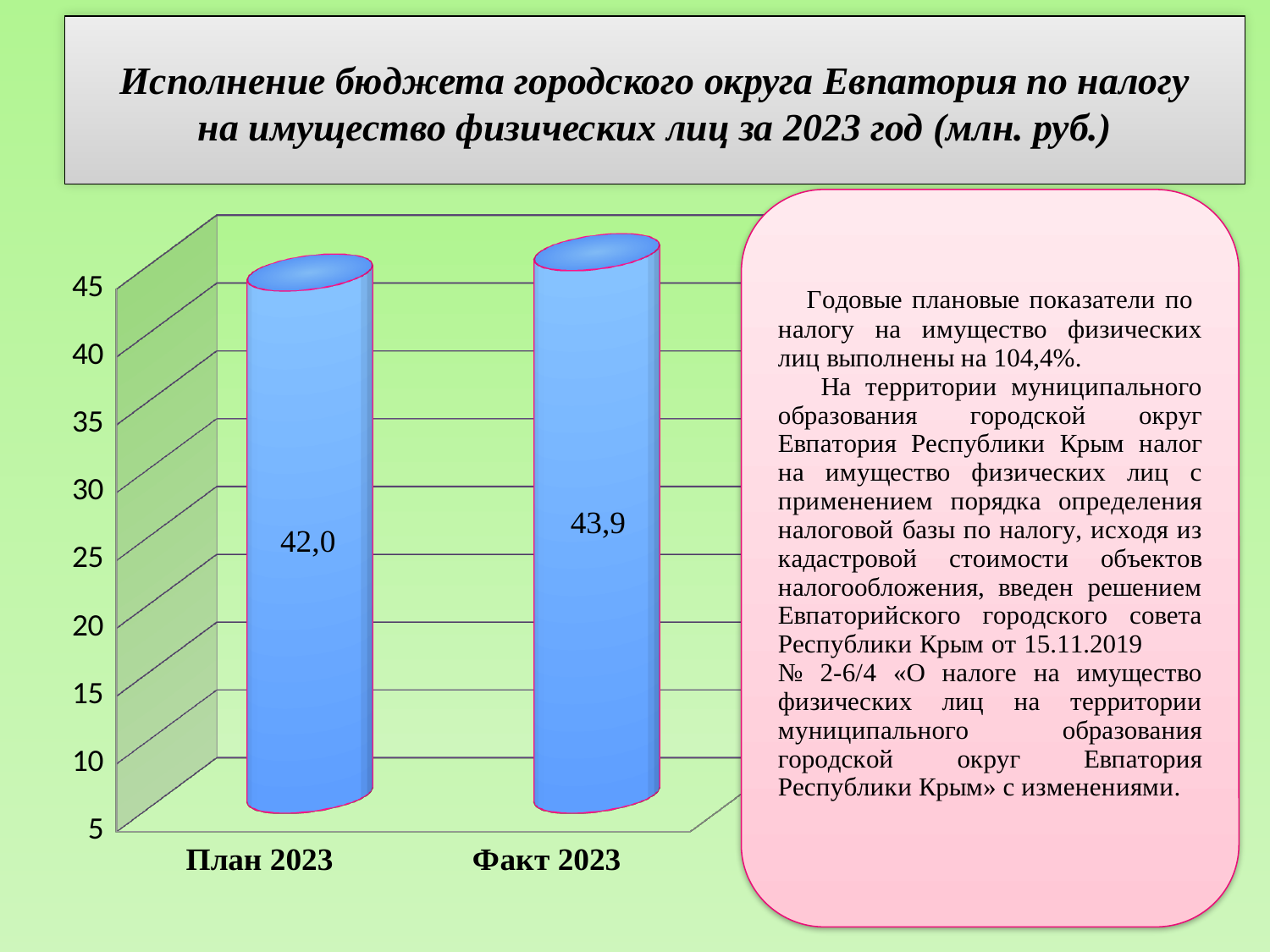
Do the values rise or fall from План 2023 to Факт 2023? rise What kind of chart is shown on the slide? bar chart Is the value for План 2023 larger or smaller than the value for Факт 2023? smaller What is the difference between the values for Факт 2023 and План 2023? 1,9 What is the highest value shown on the vertical axis of the chart? 45 Which category has the lower value? План 2023 How many categories are shown on the chart? 2 What is the value for Факт 2023? 43,9 What is the value for План 2023? 42,0 Which category has the higher value, План 2023 or Факт 2023? Факт 2023 Is the value for План 2023 greater or less than 40? greater